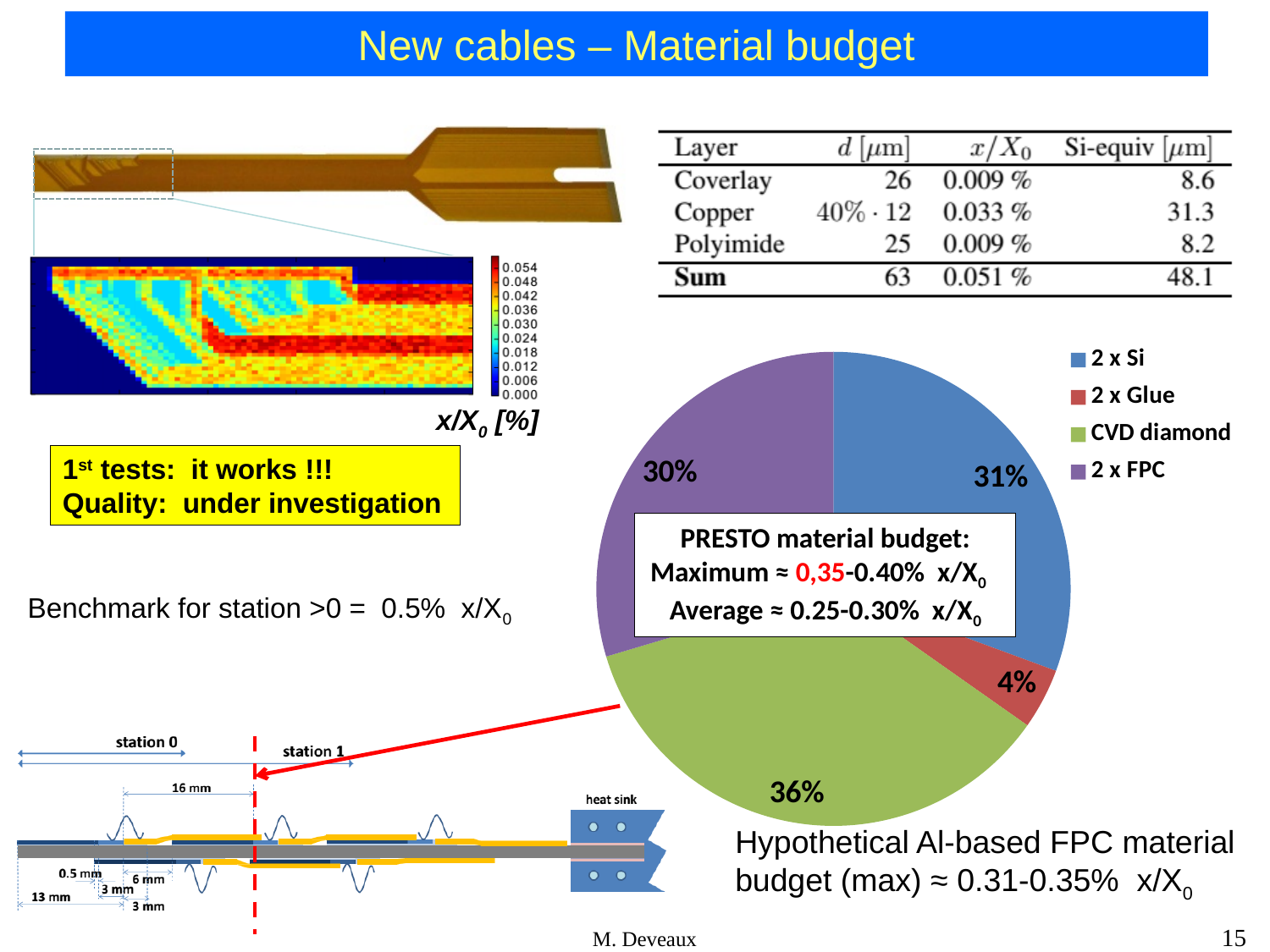
What kind of chart is shown on the right side of the slide? pie chart In the pie chart, what share is labelled for 2 x Si? 31% In the pie chart, what is the difference in percentage points between the CVD diamond slice and the 2 x FPC slice? 6 In the pie chart, what share is labelled for 2 x Glue? 4% In the pie chart, which is larger: the 2 x Si slice or the 2 x Glue slice? 2 x Si In the pie chart legend, which entry is shown in green? CVD diamond Which slice of the pie chart is the smallest? 2 x Glue How many slices does the pie chart have? 4 How many entries does the legend of the pie chart list? 4 Which slice of the pie chart is the largest? CVD diamond In the pie chart, what share is labelled for 2 x FPC? 30% In the pie chart, what share is labelled for CVD diamond? 36%